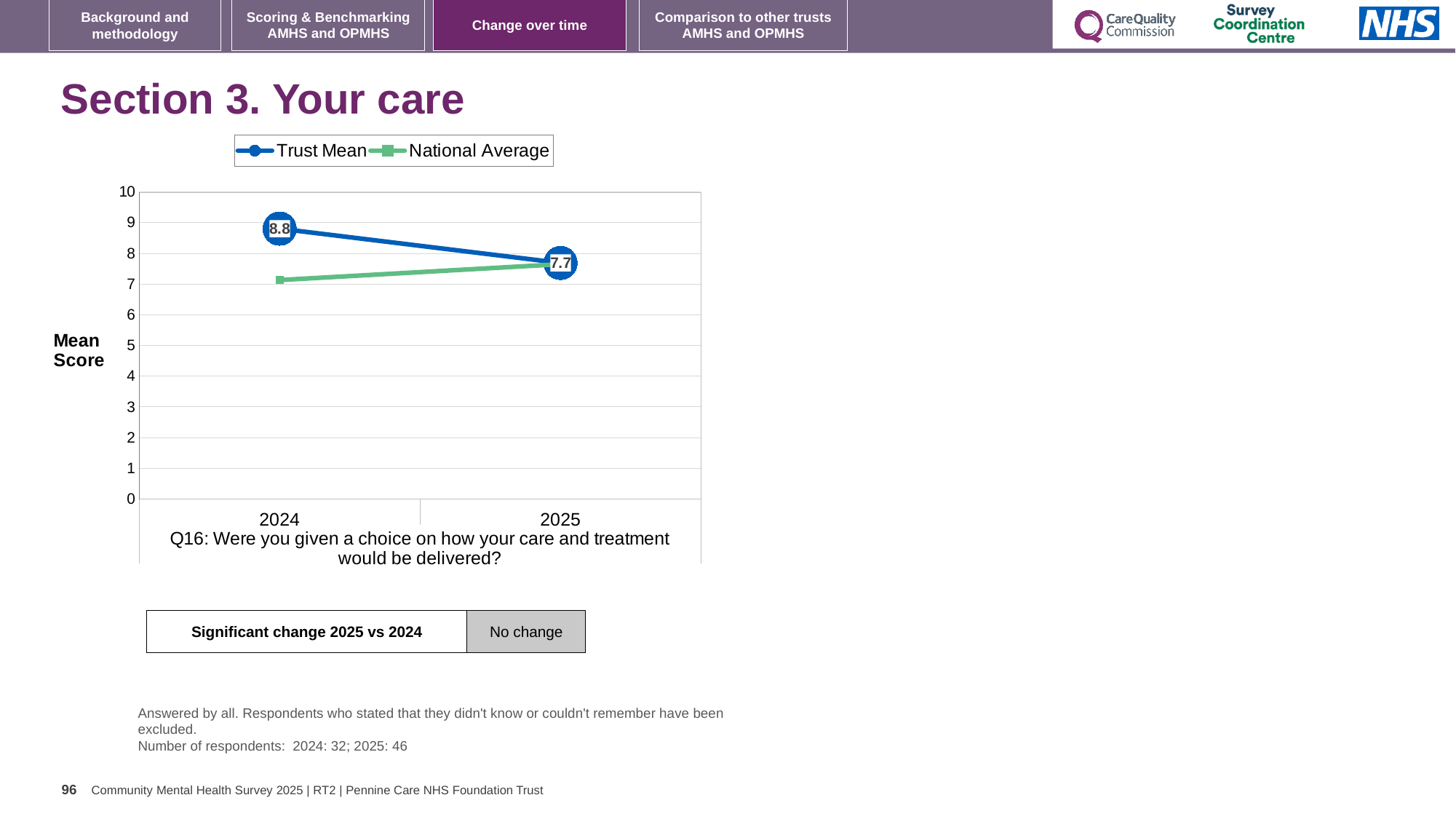
Is the National Average value for 2024 greater or less than 6? greater Is the National Average value for 2024 greater or less than 8? less In 2024, which series has the higher value, Trust Mean or National Average? Trust Mean How many series does the legend list? 2 What kind of chart is shown on the slide? Line chart Which is larger, the Trust Mean for 2024 or the Trust Mean for 2025? 2024 How many years are shown on the x axis of the chart? 2 By how much did the Trust Mean score change between 2024 and 2025? 1.1 Does the Trust Mean rise or fall from 2024 to 2025? Fall What is the Trust Mean score for 2025? 7.7 In which year is the Trust Mean score highest? 2024 What is the Trust Mean score for 2024? 8.8